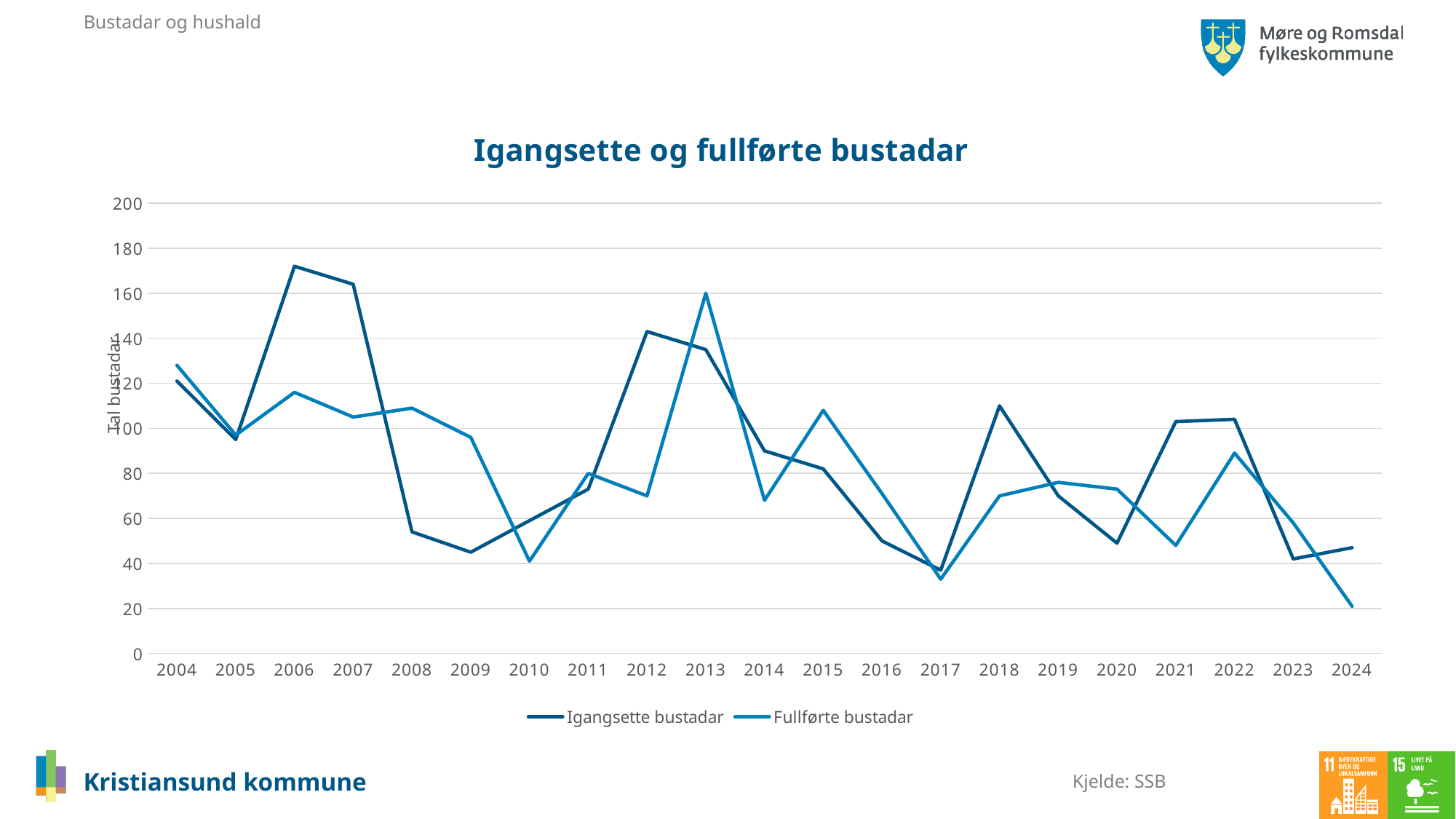
In 2006, which series has the larger value, Igangsette bustadar or Fullførte bustadar? Igangsette bustadar Is the value for Igangsette bustadar in 2009 greater or less than 60? less What kind of chart is shown on the slide? line chart In which year is the value for Fullførte bustadar highest? 2013 How many years are shown on the x axis? 21 Is the value for Fullførte bustadar in 2024 greater or less than 40? less Is the value for Igangsette bustadar in 2006 greater or less than 160? greater In which year is the value for Fullførte bustadar lowest? 2024 In which year is the value for Igangsette bustadar highest? 2006 In 2013, which series has the larger value, Igangsette bustadar or Fullførte bustadar? Fullførte bustadar Does the value for Igangsette bustadar rise or fall from 2006 to 2009? fall How many series does the legend list? 2